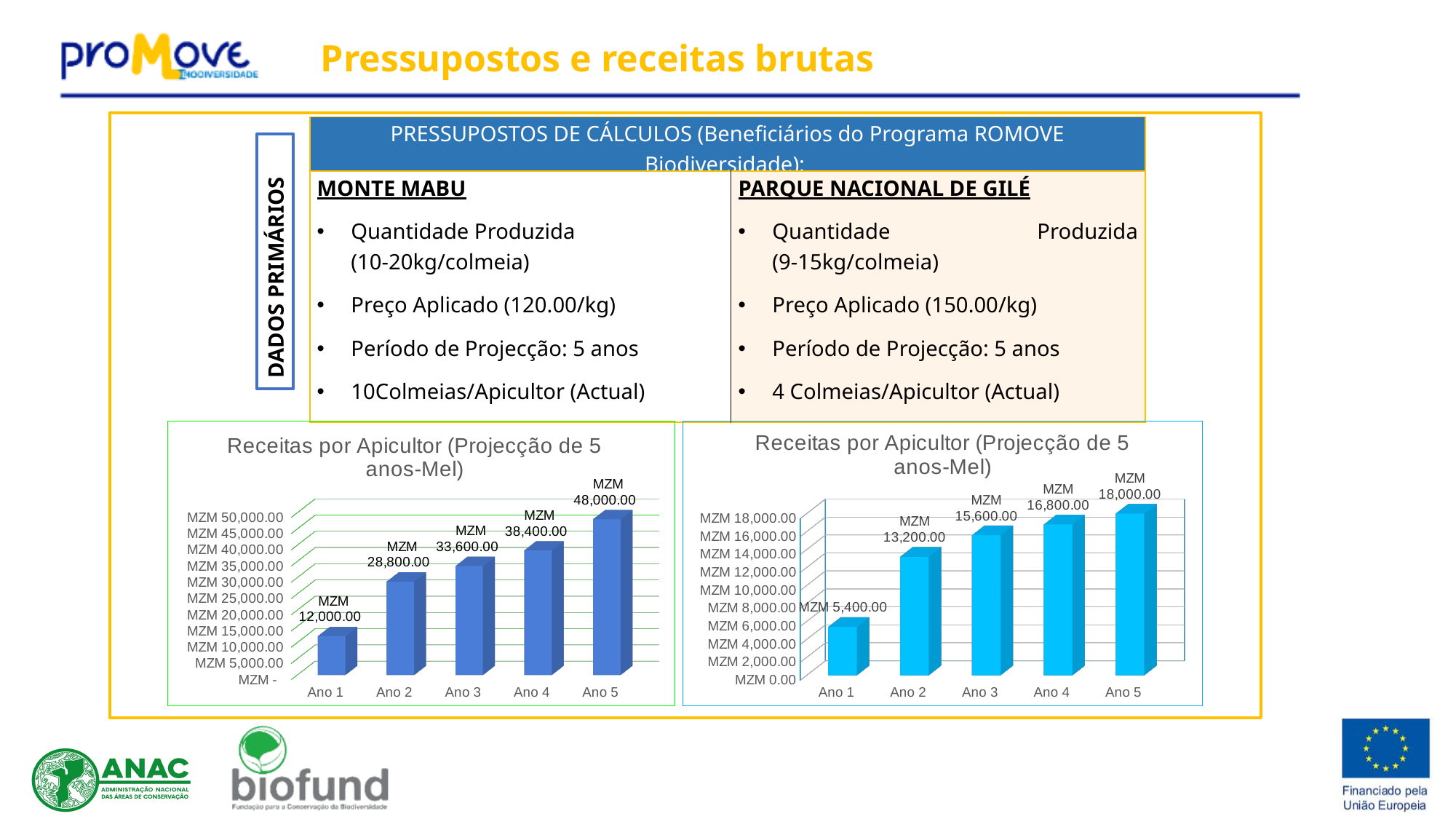
In the left chart, what is the value for Ano 1? MZM 12,000.00 What kind of chart is the right chart? bar chart Which is larger: the value for Ano 5 in the left chart or the value for Ano 5 in the right chart? Ano 5 in the left chart In the right chart, what is the value for Ano 2? MZM 13,200.00 In the left chart, what is the difference between the values for Ano 5 and Ano 4? MZM 9,600.00 In the left chart, do the values rise or fall from Ano 1 to Ano 5? rise In the left chart, which year has the lowest value? Ano 1 In the left chart, what is the value for Ano 3? MZM 33,600.00 In the right chart, what is the difference between the values for Ano 2 and Ano 1? MZM 7,800.00 In the right chart, is the value for Ano 3 greater or less than MZM 14,000.00? greater How many years are plotted in the left chart? 5 In the right chart, which year has the highest value? Ano 5